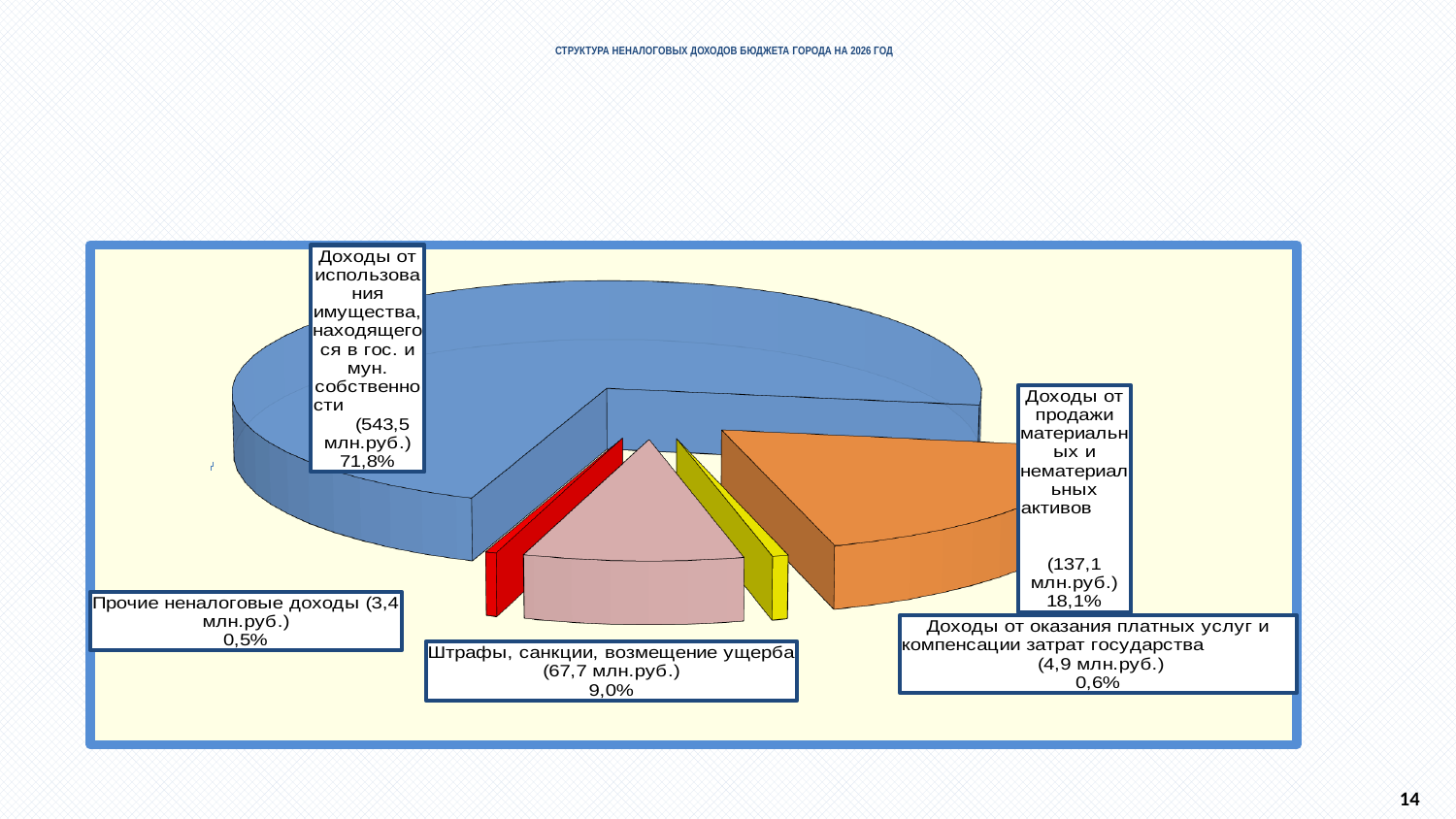
What is the value in млн.руб. for "Доходы от продажи материальных и нематериальных активов"? 137,1 млн.руб. What is the difference in percentage points between the share of "Доходы от использования имущества, находящегося в гос. и мун. собственности" and "Доходы от продажи материальных и нематериальных активов"? 53,7 What share of the pie does "Доходы от оказания платных услуг и компенсации затрат государства" have? 0,6% Which category has the largest share of the pie? Доходы от использования имущества, находящегося в гос. и мун. собственности Which category has the smallest share of the pie? Прочие неналоговые доходы What share of the pie does "Доходы от использования имущества, находящегося в гос. и мун. собственности" have? 71,8% What is the title of the chart? СТРУКТУРА НЕНАЛОГОВЫХ ДОХОДОВ БЮДЖЕТА ГОРОДА НА 2026 ГОД What kind of chart is shown on the slide? Pie chart How many slices does the pie chart have? 5 Which is larger: "Доходы от продажи материальных и нематериальных активов" or "Штрафы, санкции, возмещение ущерба"? Доходы от продажи материальных и нематериальных активов What is the value in млн.руб. for "Прочие неналоговые доходы"? 3,4 млн.руб. What is the value in млн.руб. for "Штрафы, санкции, возмещение ущерба"? 67,7 млн.руб.